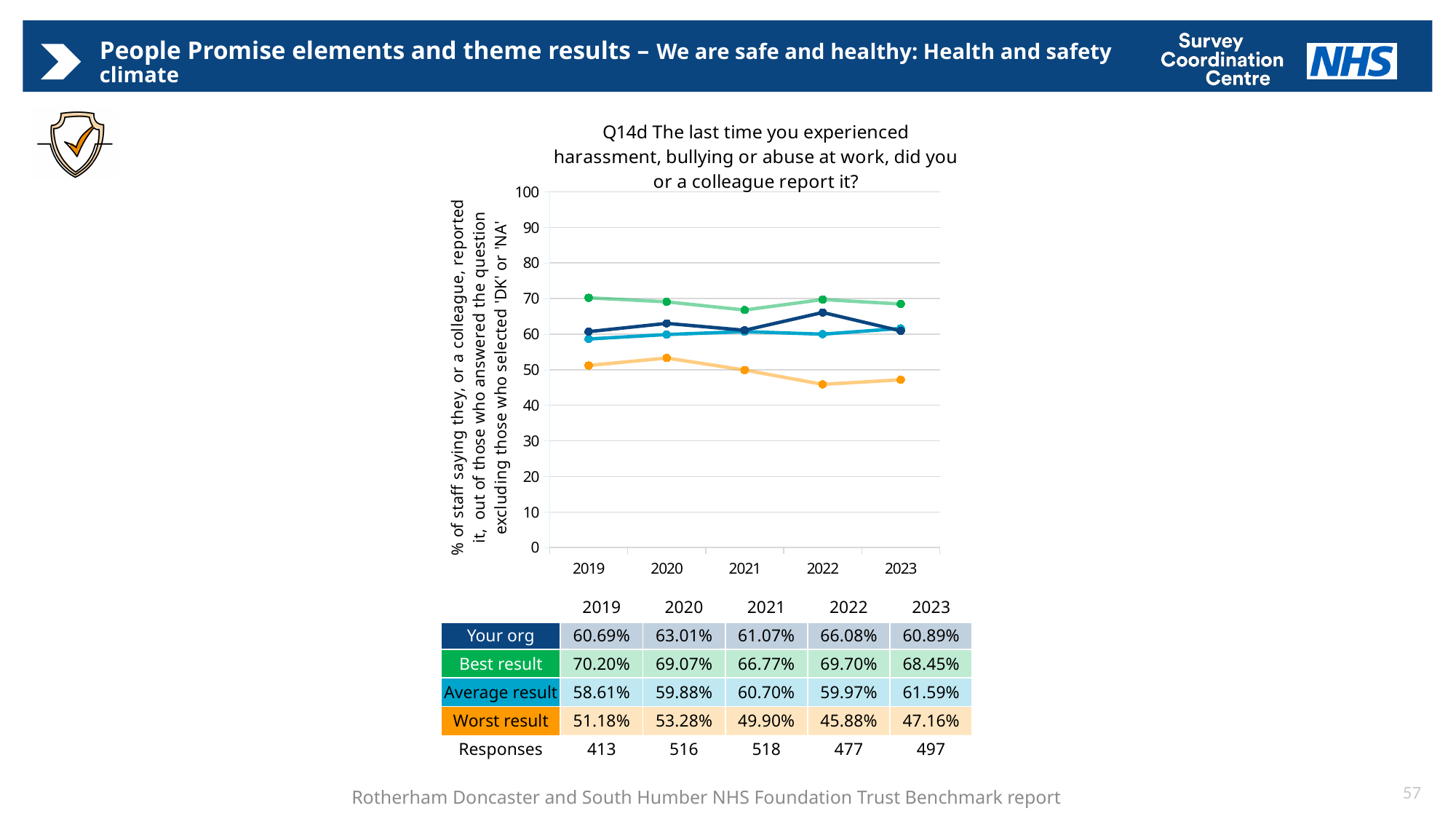
In which year was the 'Your org' value highest? 2022 Which is larger in 2023: the 'Your org' value or the 'Average result' value? Average result What was the 'Your org' value in 2022? 66.08% What is the difference between the 'Your org' and 'Average result' values in 2022? 6.11 percentage points How many responses were recorded in 2020? 516 What was the 'Average result' value in 2023? 61.59% How many years are plotted on the x axis? 5 In which year was the 'Worst result' value lowest? 2022 What was the 'Worst result' value in 2021? 49.90% What type of chart is shown on the slide? Line chart How many series are plotted on the chart? 4 What was the 'Best result' value in 2019? 70.20%